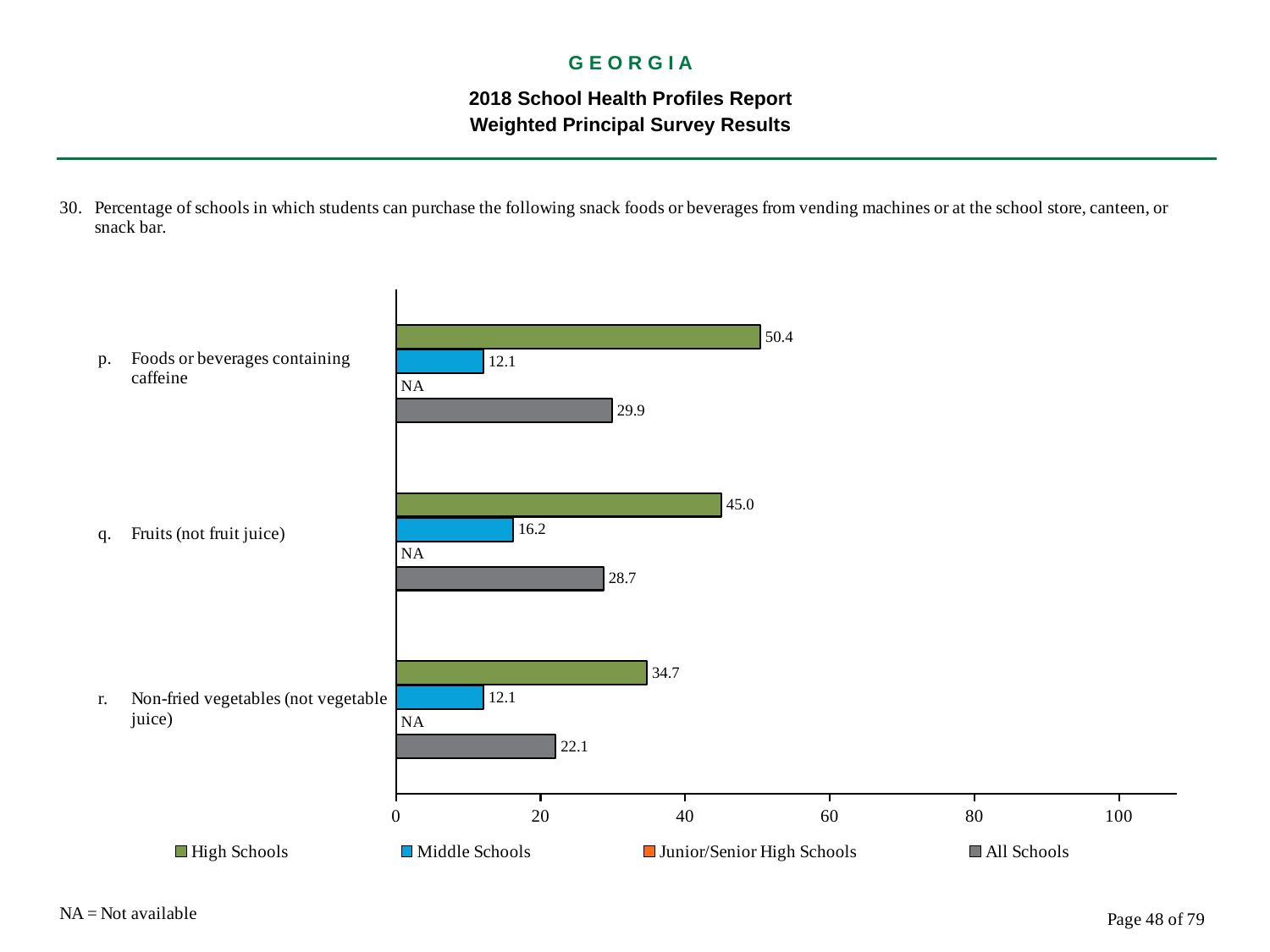
What is the value for High Schools for "Foods or beverages containing caffeine"? 50.4 Is the High Schools value for "Fruits (not fruit juice)" greater or less than 40? greater What is the difference between the High Schools and Middle Schools values for "Foods or beverages containing caffeine"? 38.3 Which category has the highest High Schools value? Foods or beverages containing caffeine Which category has the lowest All Schools value? Non-fried vegetables (not vegetable juice) Which is larger: the All Schools value for "Fruits (not fruit juice)" or the All Schools value for "Non-fried vegetables (not vegetable juice)"? Fruits (not fruit juice) How many categories are shown on the chart? 3 What is the value for Middle Schools for "Fruits (not fruit juice)"? 16.2 What is the value for All Schools for "Non-fried vegetables (not vegetable juice)"? 22.1 What is shown for Junior/Senior High Schools for "Fruits (not fruit juice)"? NA What kind of chart is shown on the slide? bar chart How many series does the legend list? 4